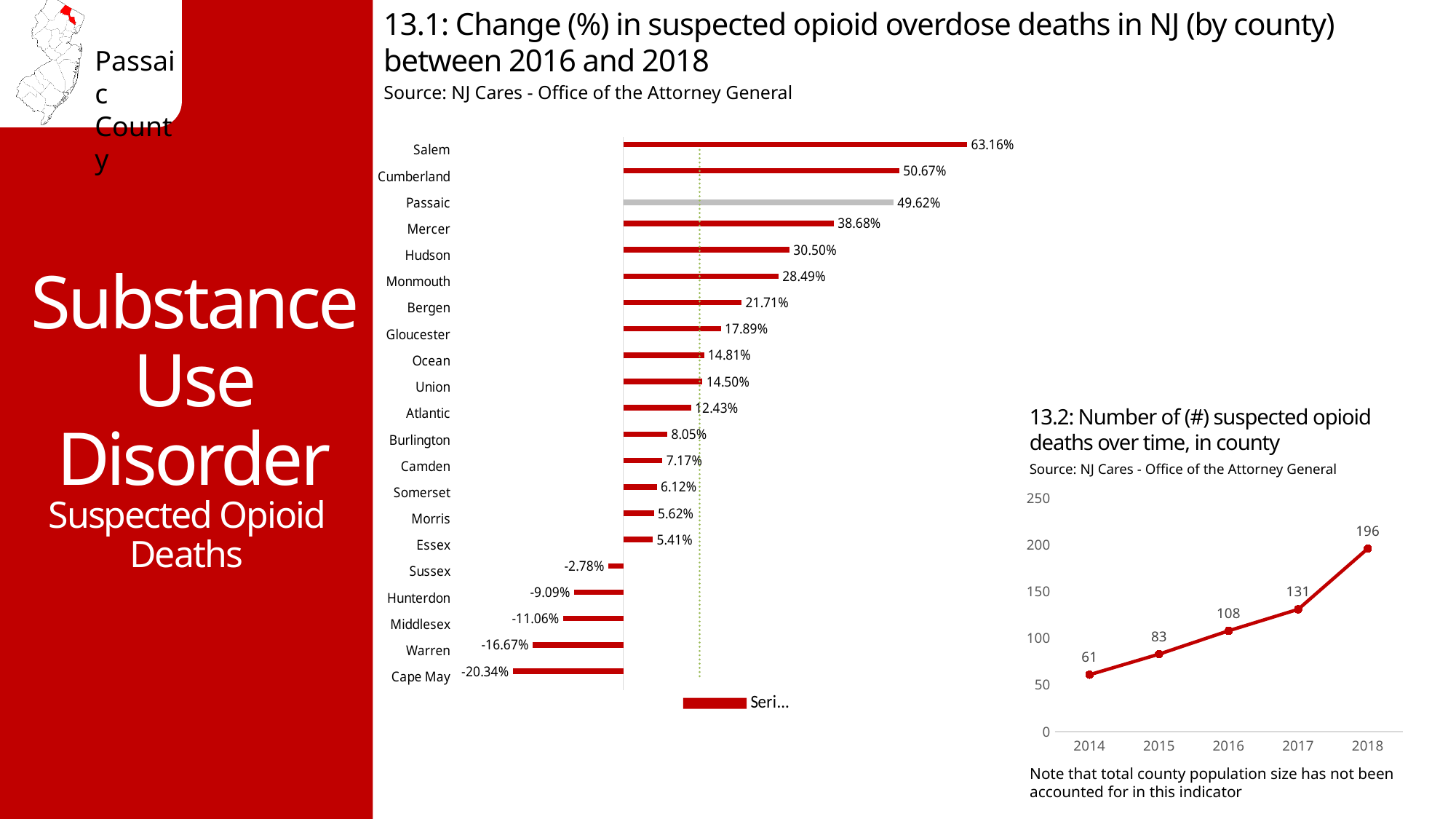
In chart 13.2, how many suspected opioid deaths were there in 2018? 196 What kind of chart is chart 13.2? Line chart In chart 13.2, do the values rise or fall from 2014 to 2018? Rise In chart 13.1, what is the change (%) in suspected opioid overdose deaths for Passaic? 49.62% In chart 13.1, what is the value for Hunterdon? -9.09% In chart 13.1, which county has the lowest change (%) in suspected opioid overdose deaths? Cape May In chart 13.1, what is the difference between the values for Salem and Cumberland? 12.49% In chart 13.1, which county has the highest change (%) in suspected opioid overdose deaths? Salem In chart 13.1, which is larger, the value for Mercer or the value for Hudson? Mercer How many counties are shown in chart 13.1? 21 What kind of chart is chart 13.1? Bar chart In chart 13.2, what is the difference in suspected opioid deaths between 2017 and 2016? 23